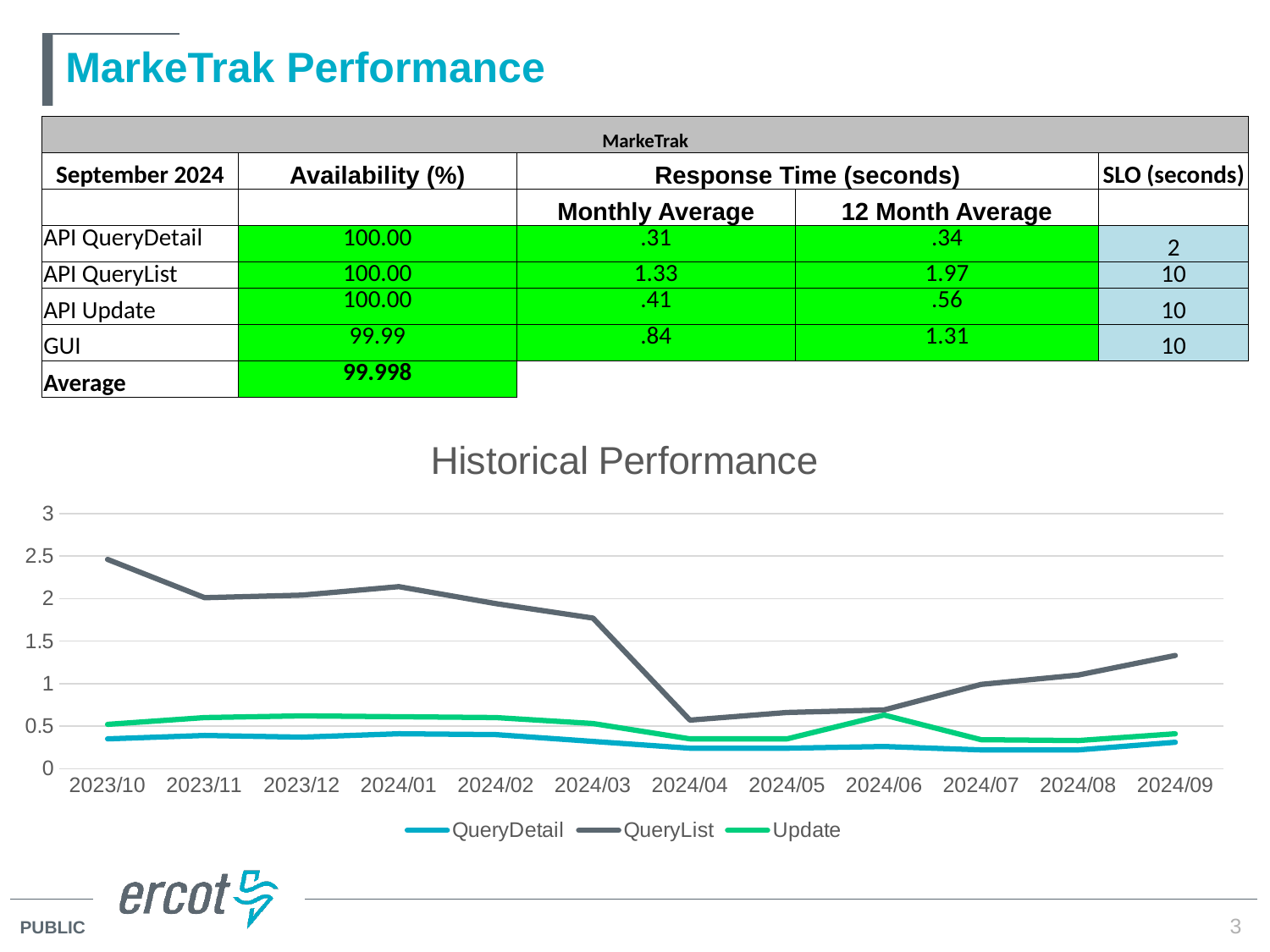
In the Historical Performance chart, does the QueryList series rise or fall from 2023/10 to 2024/04? fall In the Historical Performance chart, at which month does the QueryList series reach its highest value? 2023/10 In the Historical Performance chart, which is larger at 2024/09: QueryList or QueryDetail? QueryList In the Historical Performance chart, is the QueryList value at 2023/10 greater or less than 2? greater In the Historical Performance chart, is the QueryList value at 2024/04 greater or less than 1? less How many series does the legend of the Historical Performance chart list? 3 What kind of chart is the Historical Performance chart? line chart What is the title of the line chart on the slide? Historical Performance Which series in the Historical Performance chart is drawn in dark gray? QueryList In the Historical Performance chart, is the Update value at 2024/07 greater or less than 0.5? less How many months are shown on the x axis of the Historical Performance chart? 12 In the Historical Performance chart, which series has the highest value at 2023/10? QueryList